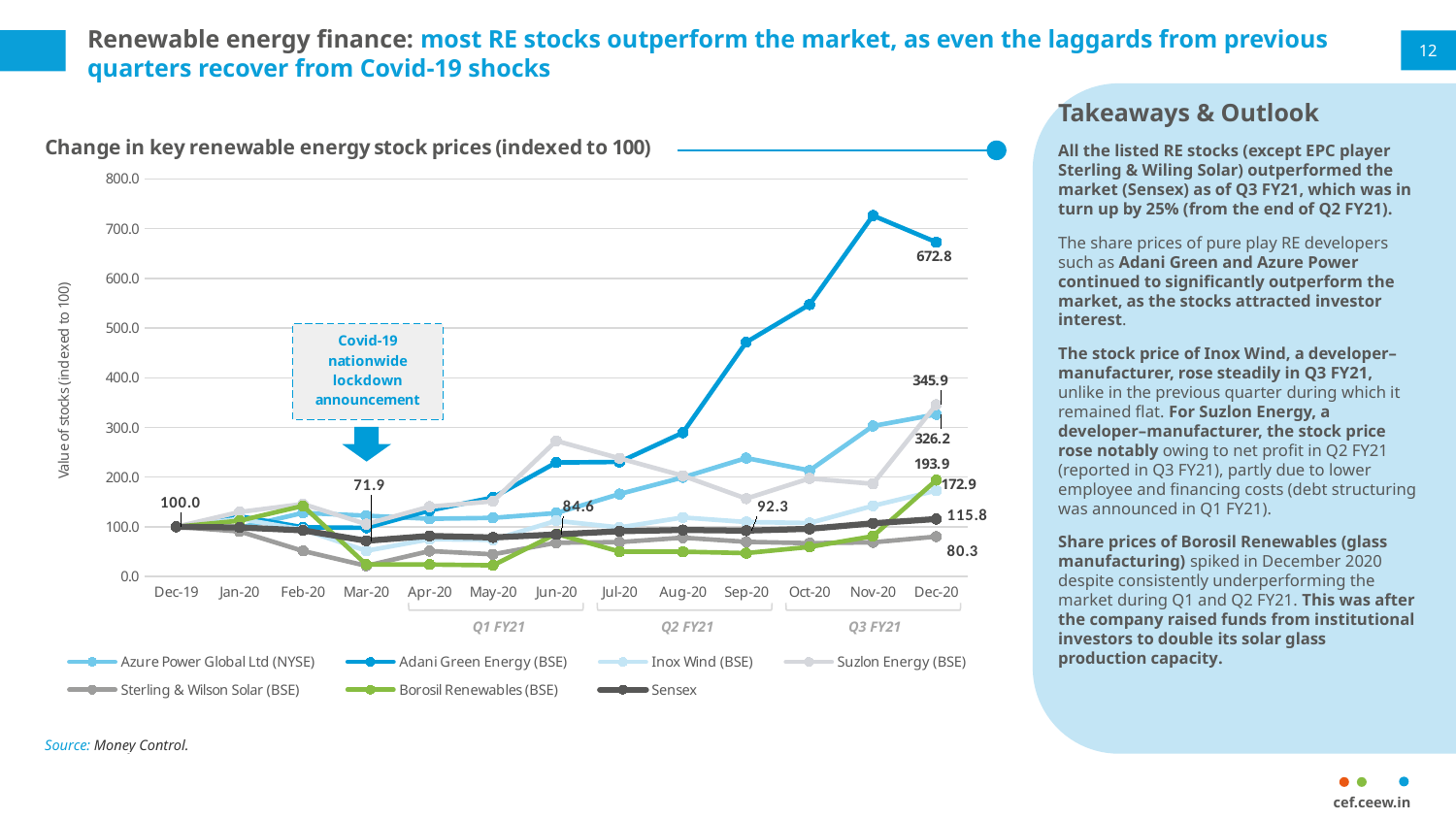
Is the value for Adani Green Energy (BSE) in Nov-20 greater or less than 700.0? greater What is the indexed value of the Sensex in Dec-20? 115.8 Which series has the lowest indexed value in Dec-20? Sterling & Wilson Solar (BSE) What is the indexed value of the Sensex in Mar-20? 71.9 What is the indexed value of Sterling & Wilson Solar (BSE) in Dec-20? 80.3 In Dec-20, which is higher: Inox Wind (BSE) or Borosil Renewables (BSE)? Borosil Renewables (BSE) What kind of chart is shown on the slide? Line chart How many series does the legend of the chart list? 7 How many months are shown along the x axis of the chart? 13 What is the indexed value of Adani Green Energy (BSE) in Dec-20? 672.8 Which stock has the highest indexed value in Dec-20? Adani Green Energy (BSE) By how much does the Dec-20 value of Adani Green Energy (BSE) exceed the Dec-20 value of the Sensex? 557.0